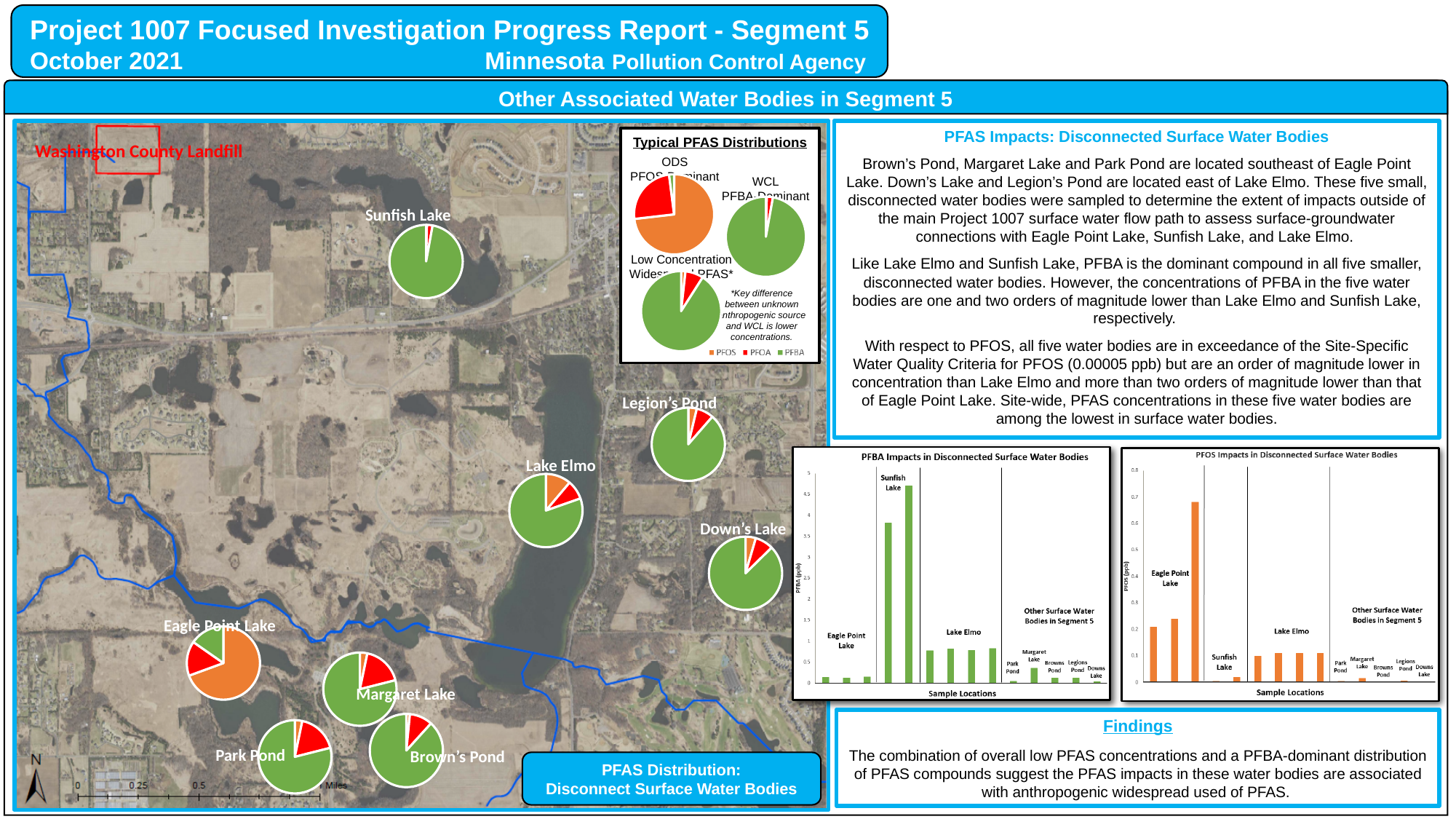
In the 'PFOS Impacts in Disconnected Surface Water Bodies' chart, which has higher bars, Eagle Point Lake or Lake Elmo? Eagle Point Lake In the 'PFBA Impacts in Disconnected Surface Water Bodies' chart, which has higher bars, Sunfish Lake or Lake Elmo? Sunfish Lake In the 'PFOS Impacts in Disconnected Surface Water Bodies' chart, which sample location has the tallest bar? Eagle Point Lake In the 'PFOS Impacts in Disconnected Surface Water Bodies' chart, is the tallest Eagle Point Lake bar greater or less than 0.6? greater In the 'PFBA Impacts in Disconnected Surface Water Bodies' chart, which sample location has the tallest bar? Sunfish Lake What kind of chart is the 'PFBA Impacts in Disconnected Surface Water Bodies' chart? bar chart What is the x-axis title of the 'PFOS Impacts in Disconnected Surface Water Bodies' chart? Sample Locations In the 'PFBA Impacts in Disconnected Surface Water Bodies' chart, how many water bodies are named under 'Other Surface Water Bodies in Segment 5'? 5 In the 'PFOS Impacts in Disconnected Surface Water Bodies' chart, is the Sunfish Lake bar greater or less than 0.1? less How many compounds does the legend of the 'Typical PFAS Distributions' pie charts list? 3 In the 'PFBA Impacts in Disconnected Surface Water Bodies' chart, is the tallest Sunfish Lake bar greater or less than 4? greater